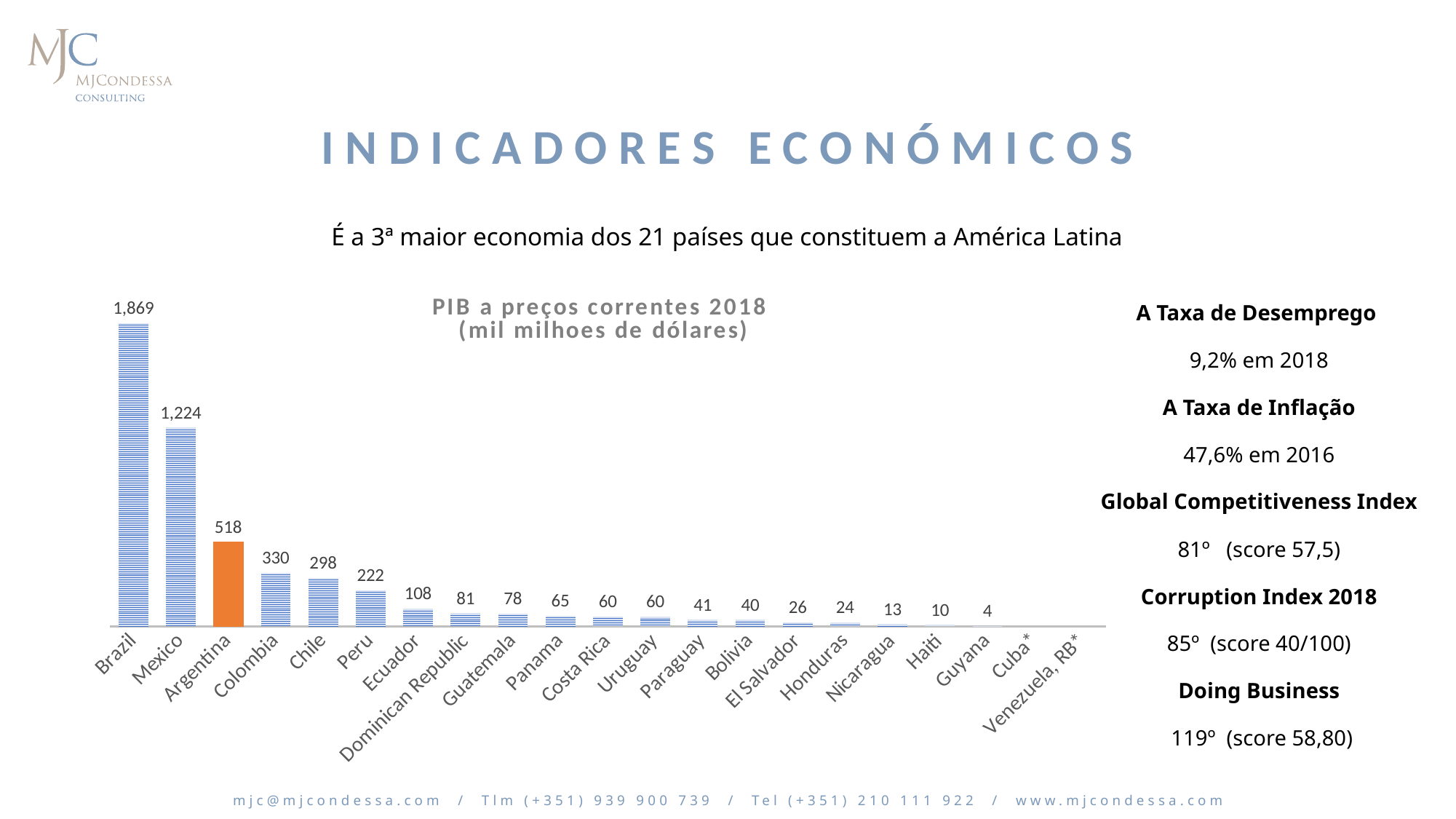
Which country has the highest value in the chart? Brazil What kind of chart is shown on the slide? Bar chart Which country's bar is highlighted in orange? Argentina What is the difference between the values for Brazil and Mexico? 645 What is the value for Peru in the chart? 222 Do the values rise or fall from left to right along the x axis? Fall What is the value for Argentina in the chart? 518 Which has a larger value, Chile or Peru? Chile What is the value for Brazil in the chart? 1,869 What is the value for Dominican Republic in the chart? 81 How many countries are listed on the x axis of the chart? 21 What is the difference between the values for Argentina and Colombia? 188